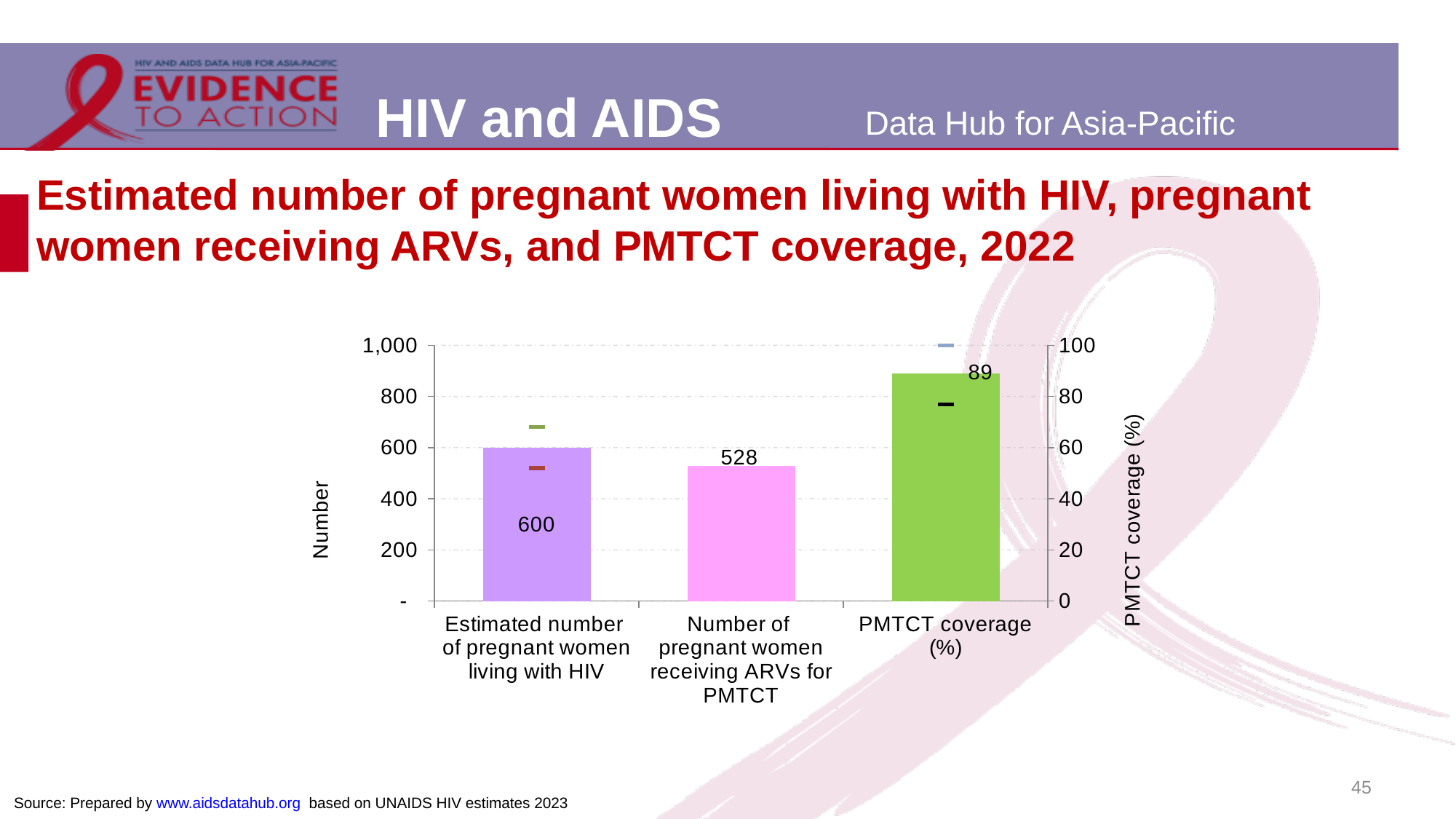
What is the label of the right vertical axis of the chart? PMTCT coverage (%) How many bars are plotted on the chart? 3 What is the label of the left vertical axis of the chart? Number Which is larger: the estimated number of pregnant women living with HIV or the number of pregnant women receiving ARVs for PMTCT? Estimated number of pregnant women living with HIV What is the difference between the estimated number of pregnant women living with HIV and the number of pregnant women receiving ARVs for PMTCT? 72 What type of chart is shown on the slide? Bar chart What is the PMTCT coverage (%) value shown on the chart? 89 Is the number of pregnant women receiving ARVs for PMTCT greater or less than 600? less What is the number of pregnant women receiving ARVs for PMTCT shown on the chart? 528 What is the maximum value shown on the right vertical axis of the chart? 100 Is the PMTCT coverage (%) value greater or less than 80? greater What is the estimated number of pregnant women living with HIV shown on the chart? 600